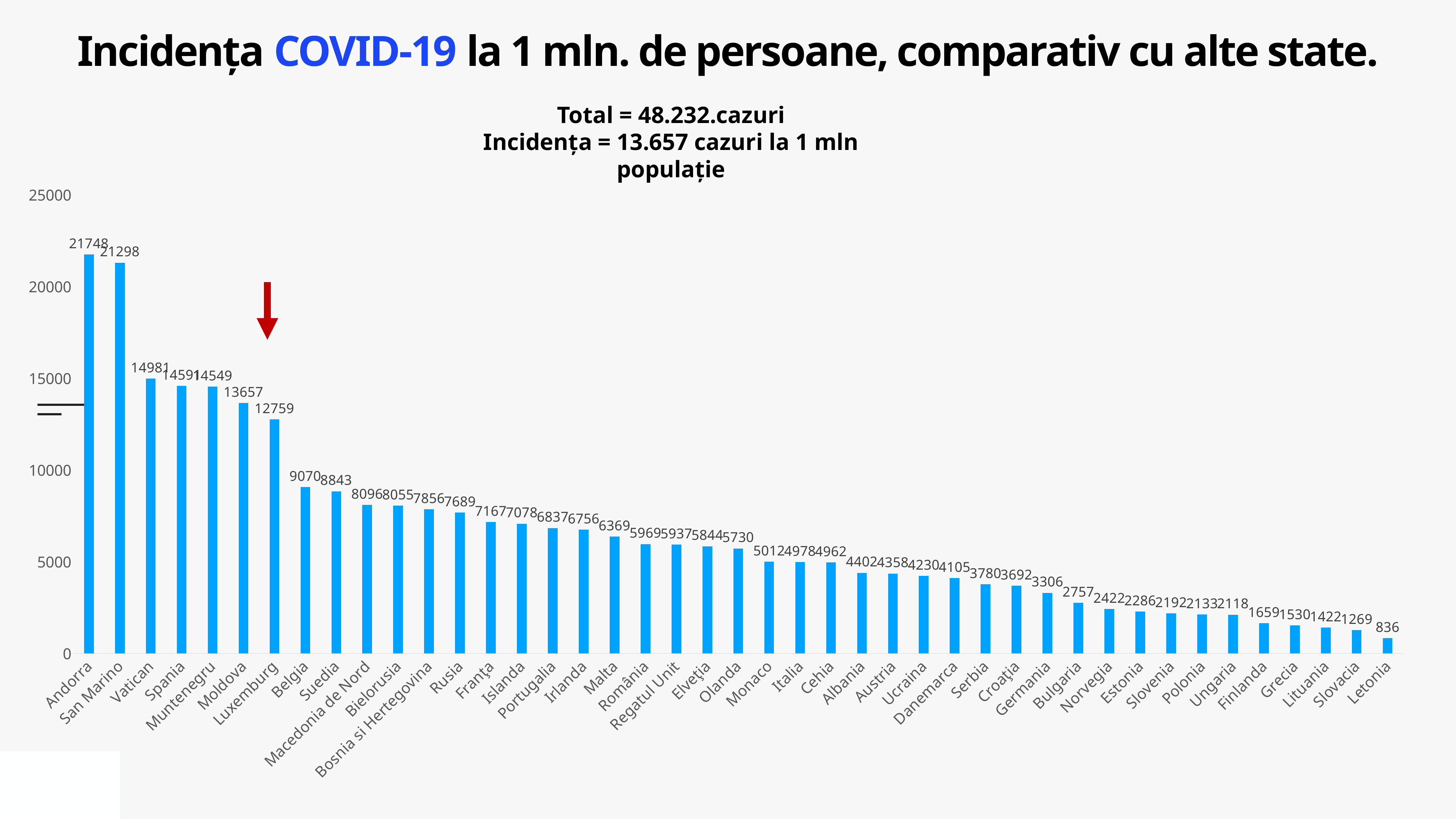
What is the value for Letonia? 836 Is the value for Germania greater or less than 5000? less How many countries are shown on the chart? 43 What is the value for Moldova? 13657 Which is larger, the value for Vatican or the value for Belgia? Vatican What is the difference between the values for Moldova and Luxemburg? 898 What is the value for Belgia? 9070 Do the values rise or fall from left to right along the x axis? fall Which country has the lowest value? Letonia What kind of chart is shown on the slide? bar chart What is the value for Andorra? 21748 Which country has the highest value? Andorra